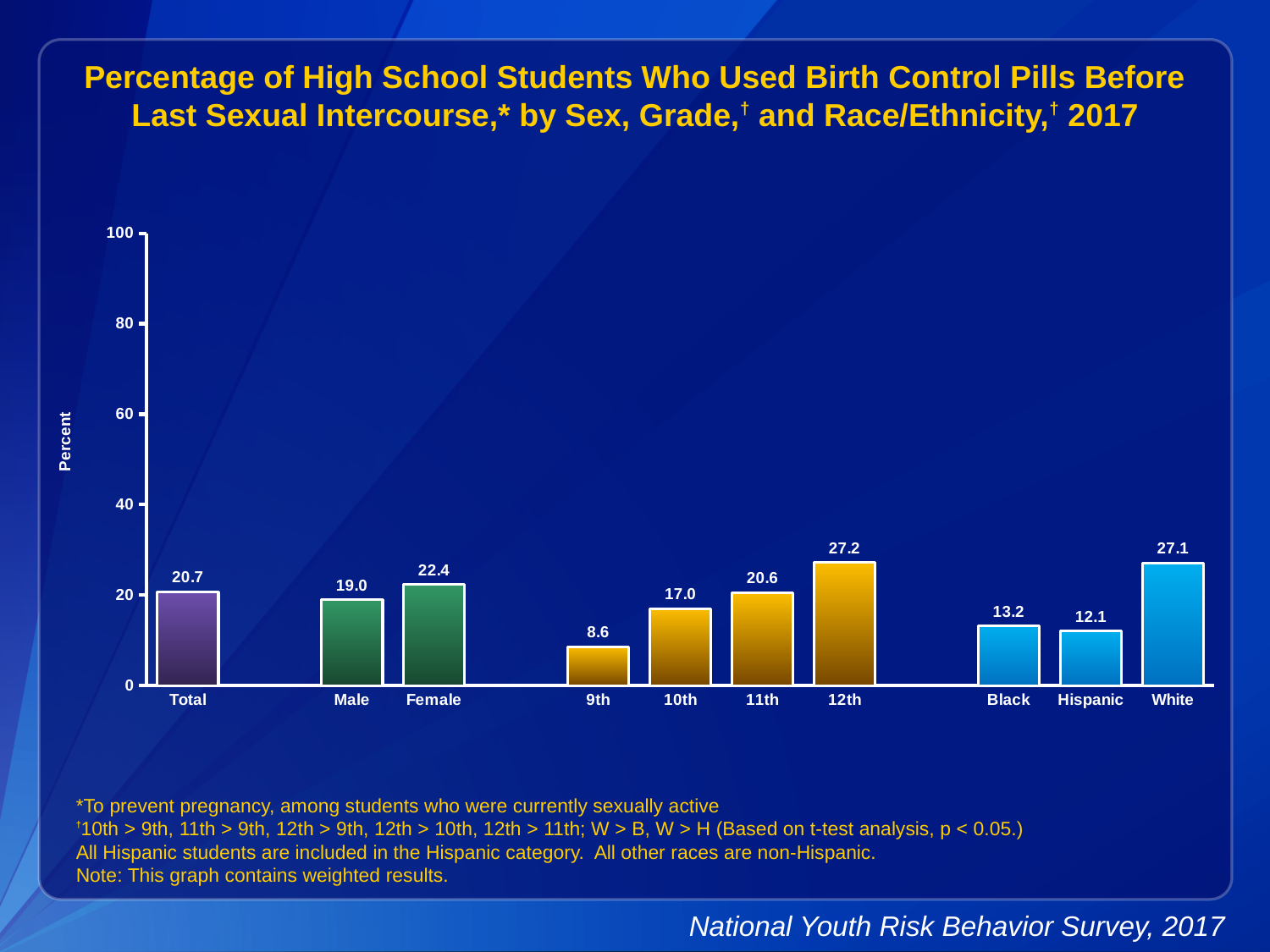
Which grade has the highest value? 12th What is the value for Total? 20.7 What is the value for 9th grade? 8.6 Is the value for White greater or less than 20? greater What kind of chart is shown on the slide? Bar chart What is the value for Female? 22.4 What is the difference between the Female and Male values? 3.4 How many bars are shown in the chart? 10 Which is larger, the value for Black or the value for Hispanic? Black What is the value for Hispanic? 12.1 Which category has the lowest value? 9th Do the values rise or fall from 9th grade to 12th grade? Rise